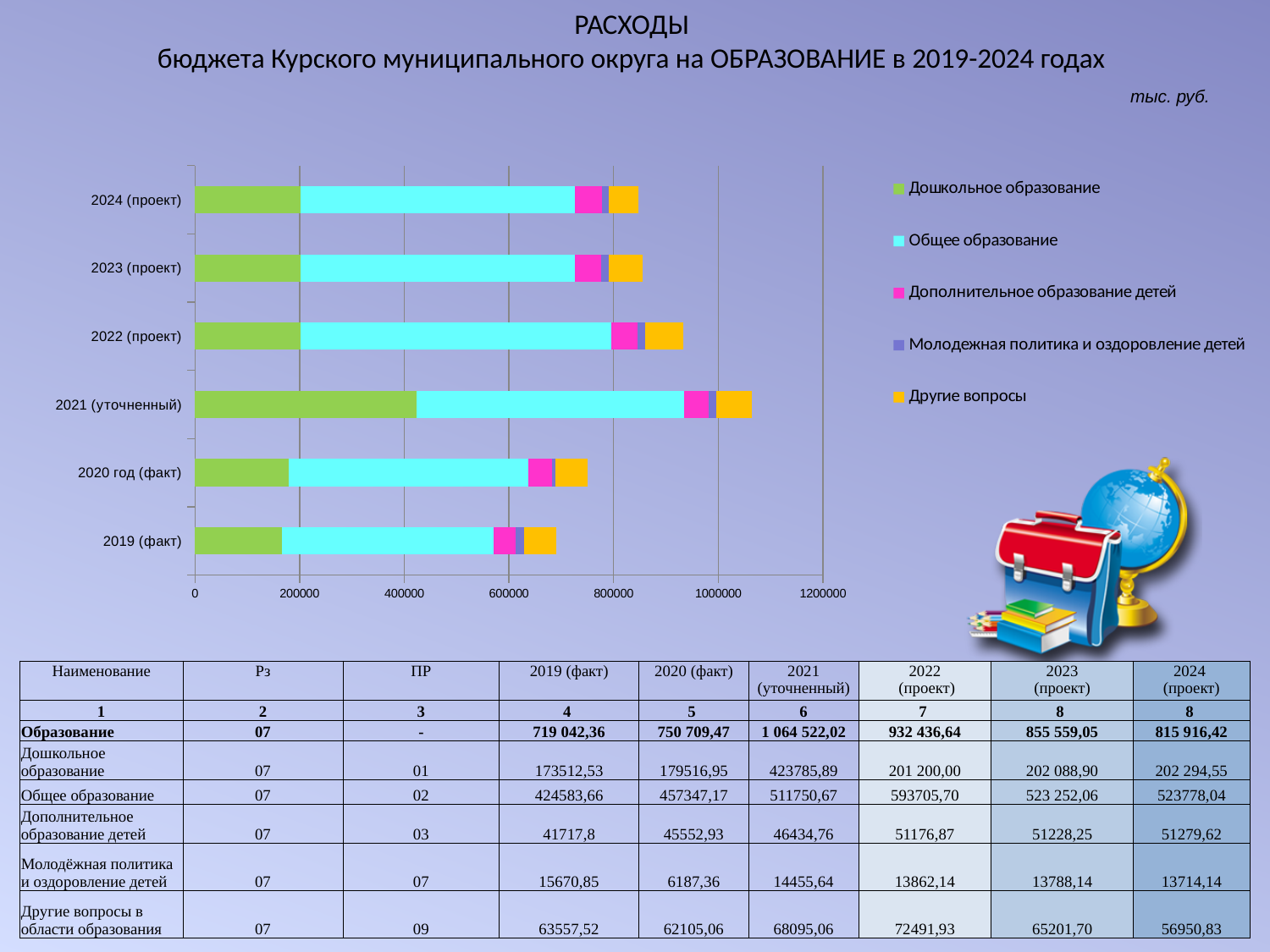
What colour represents Общее образование in the chart legend? cyan (light blue) What is the total for Образование in 2024 (проект) as printed in the table? 815 916,42 What is the value of Общее образование for 2022 (проект) as printed in the table? 593 705,70 Is the total bar for 2019 (факт) greater or less than 800000? less What kind of chart is shown on the slide? bar chart How many series does the chart legend list? 5 Which year has the longest total bar on the chart? 2021 (уточненный) Do the total bars rise or fall from 2021 (уточненный) to 2024 (проект)? fall Is the total bar for 2021 (уточненный) greater or less than 1000000? greater Is the Дошкольное образование segment larger in 2021 (уточненный) or in 2020 год (факт)? 2021 (уточненный) Which year has the shortest total bar on the chart? 2019 (факт) How many year categories are plotted on the chart? 6